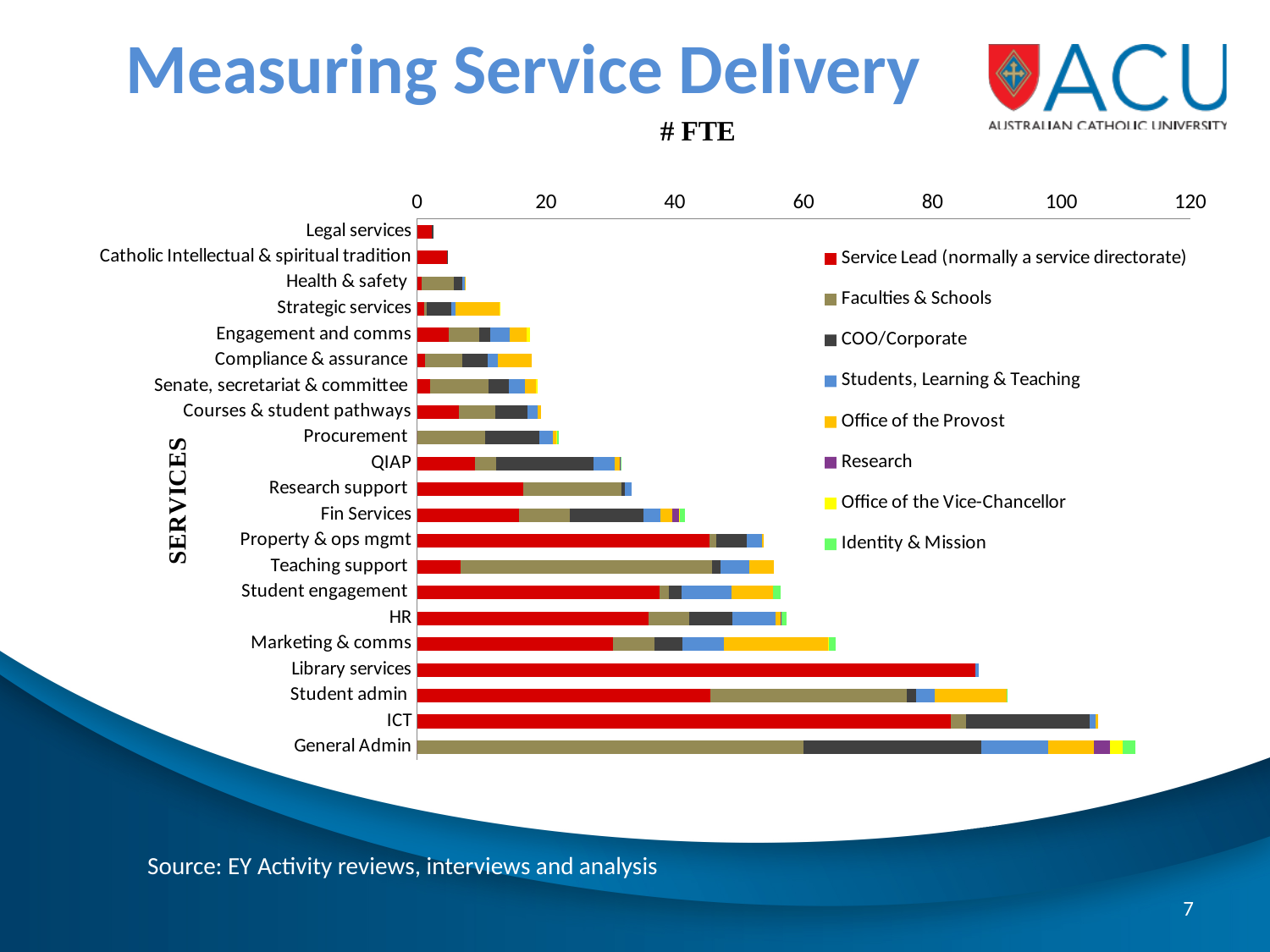
What kind of chart is shown on the slide? bar chart What is the title of the chart? # FTE How many service categories are plotted on the chart? 21 How many series does the legend list? 8 Which service has the longest total bar? General Admin Is the total value for General Admin greater or less than 100? greater Which colour represents the 'Service Lead (normally a service directorate)' series? red Is the total value for Library services greater or less than 80? greater Which has the larger total bar, Marketing & comms or Teaching support? Marketing & comms Is the total value for Legal services greater or less than 20? less Which service has the shortest total bar? Legal services